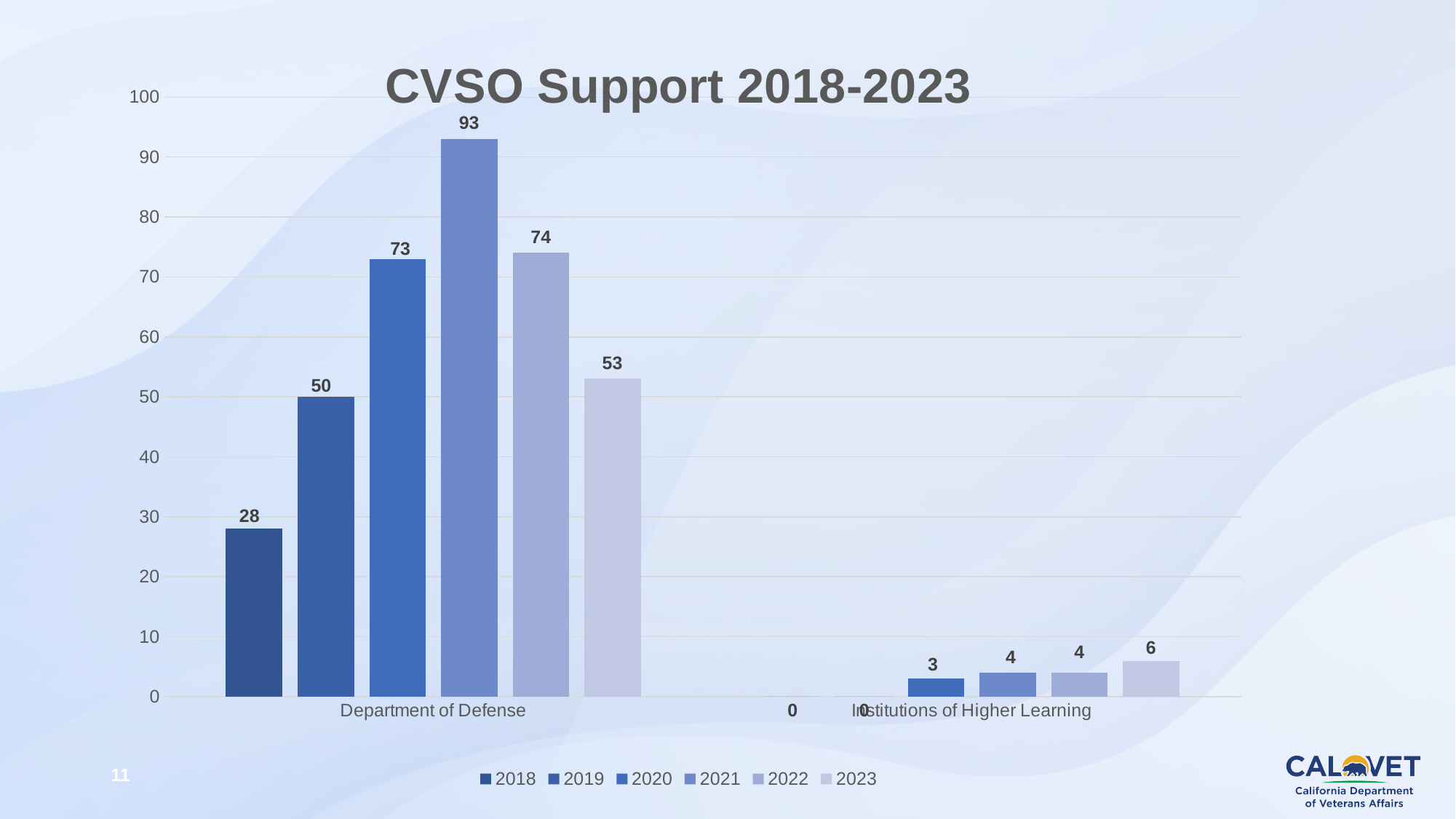
What is the value for the Department of Defense in 2018? 28 What kind of chart is shown on the slide? Bar chart What is the title of the chart? CVSO Support 2018-2023 Which year has the lowest value for the Department of Defense? 2018 What is the difference between the Department of Defense values for 2021 and 2022? 19 Which is larger for the Department of Defense, the 2019 value or the 2023 value? 2023 What is the value for Institutions of Higher Learning in 2023? 6 How many series does the legend list? 6 What is the value for Institutions of Higher Learning in 2020? 3 Which year has the highest value for the Department of Defense? 2021 What is the value for the Department of Defense in 2021? 93 How many categories are shown on the x axis? 2